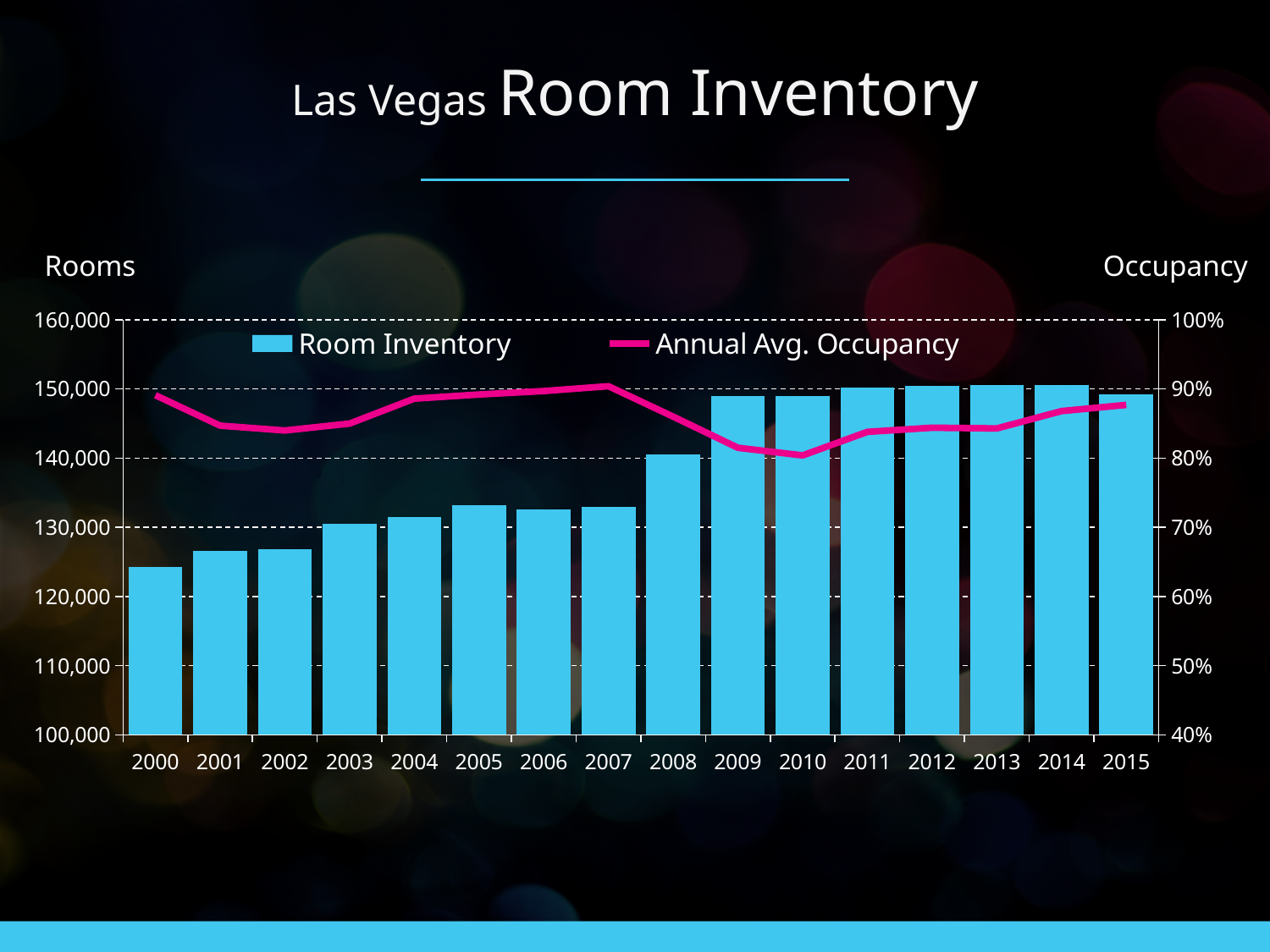
Is the Annual Avg. Occupancy for 2007 greater or less than 80%? greater Is the Room Inventory for 2009 greater or less than 140,000? greater Which is larger, the Annual Avg. Occupancy for 2007 or for 2010? 2007 What is the title of the chart? Las Vegas Room Inventory Is the Annual Avg. Occupancy for 2010 greater or less than 90%? less Does the Room Inventory generally rise or fall from 2000 to 2015? rise How many series does the legend list? 2 Which year has the lowest Room Inventory? 2000 Which is larger, the Room Inventory for 2007 or for 2008? 2008 How many years are shown on the x axis? 16 What kind of chart is shown on the slide? A combined bar and line chart